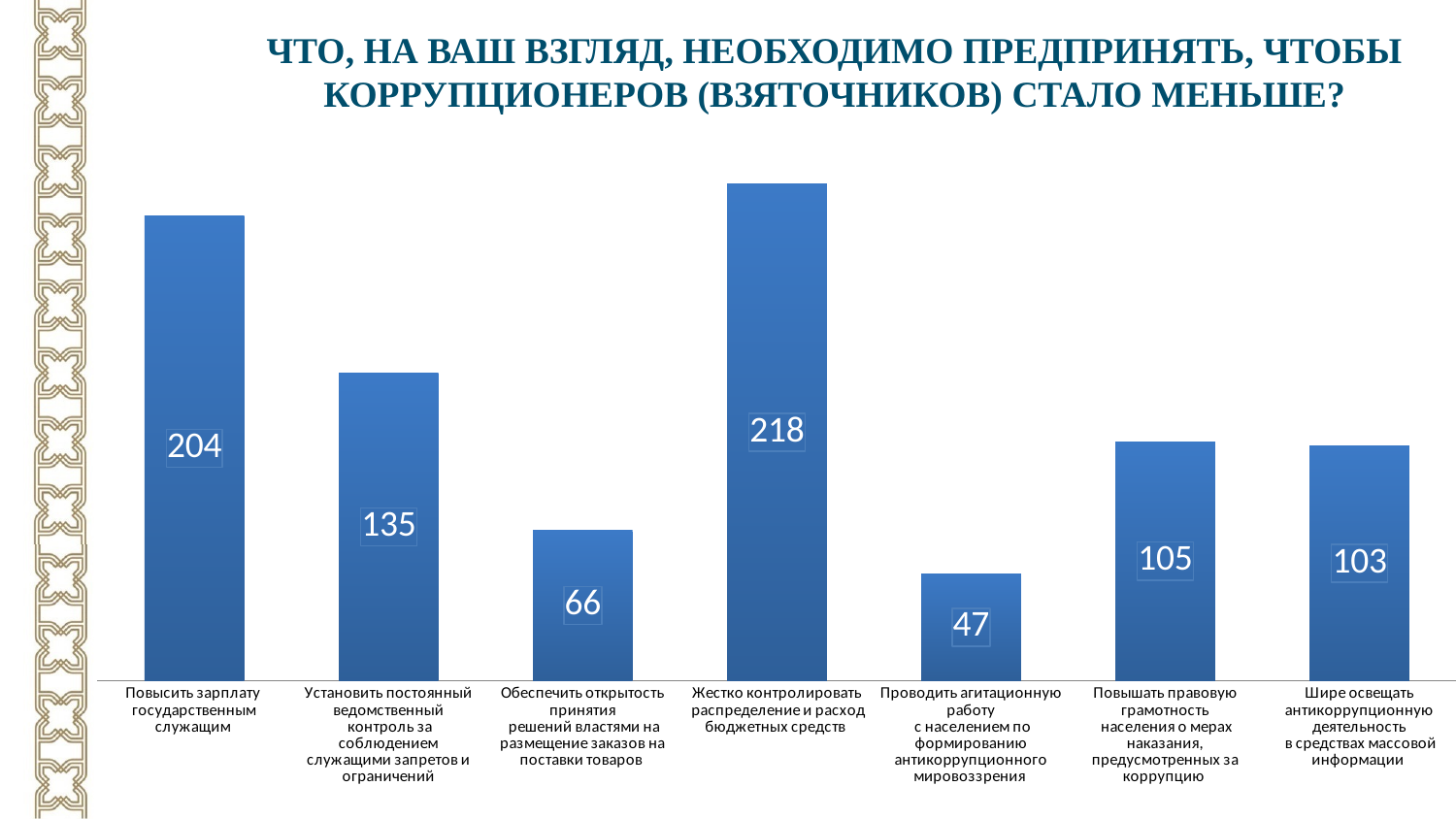
What value is shown for "Шире освещать антикоррупционную деятельность в средствах массовой информации"? 103 Which category has the lowest value? Проводить агитационную работу с населением по формированию антикоррупционного мировоззрения What is the title of the slide? ЧТО, НА ВАШ ВЗГЛЯД, НЕОБХОДИМО ПРЕДПРИНЯТЬ, ЧТОБЫ КОРРУПЦИОНЕРОВ (ВЗЯТОЧНИКОВ) СТАЛО МЕНЬШЕ? What is the difference between the values for "Жестко контролировать распределение и расход бюджетных средств" and "Повысить зарплату государственным служащим"? 14 What is the difference between the values for "Установить постоянный ведомственный контроль за соблюдением служащими запретов и ограничений" and "Обеспечить открытость принятия решений властями на размещение заказов на поставки товаров"? 69 What value is shown for "Проводить агитационную работу с населением по формированию антикоррупционного мировоззрения"? 47 Which category has the highest value? Жестко контролировать распределение и расход бюджетных средств What value is shown for "Повысить зарплату государственным служащим"? 204 What value is shown for "Жестко контролировать распределение и расход бюджетных средств"? 218 Which is larger: the value for "Повышать правовую грамотность населения о мерах наказания, предусмотренных за коррупцию" or for "Обеспечить открытость принятия решений властями на размещение заказов на поставки товаров"? Повышать правовую грамотность населения о мерах наказания, предусмотренных за коррупцию How many categories are shown in the chart? 7 What kind of chart is shown on the slide? Bar chart